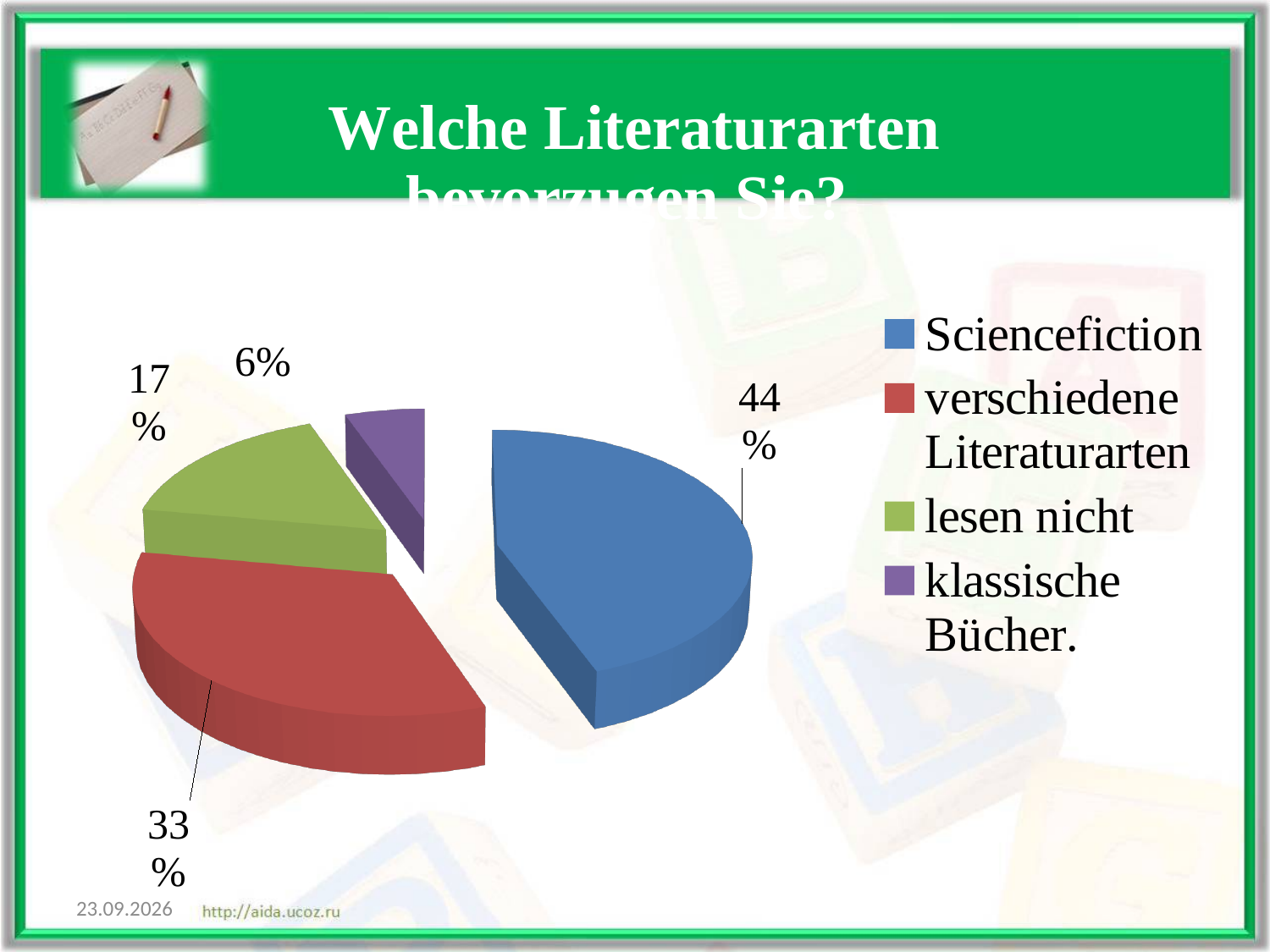
Which is larger, the share for lesen nicht or the share for klassische Bücher? lesen nicht What is the difference in percentage points between Sciencefiction and verschiedene Literaturarten? 11 Which category has the smallest slice of the pie? klassische Bücher What percentage of the pie is labelled for klassische Bücher? 6% What kind of chart is shown on the slide? pie chart How many slices does the pie chart have? 4 What percentage of the pie is labelled for lesen nicht? 17% What percentage of the pie is labelled for Sciencefiction? 44% How many entries does the legend list? 4 What colour is the slice for verschiedene Literaturarten? red Which category has the largest slice of the pie? Sciencefiction What percentage of the pie is labelled for verschiedene Literaturarten? 33%